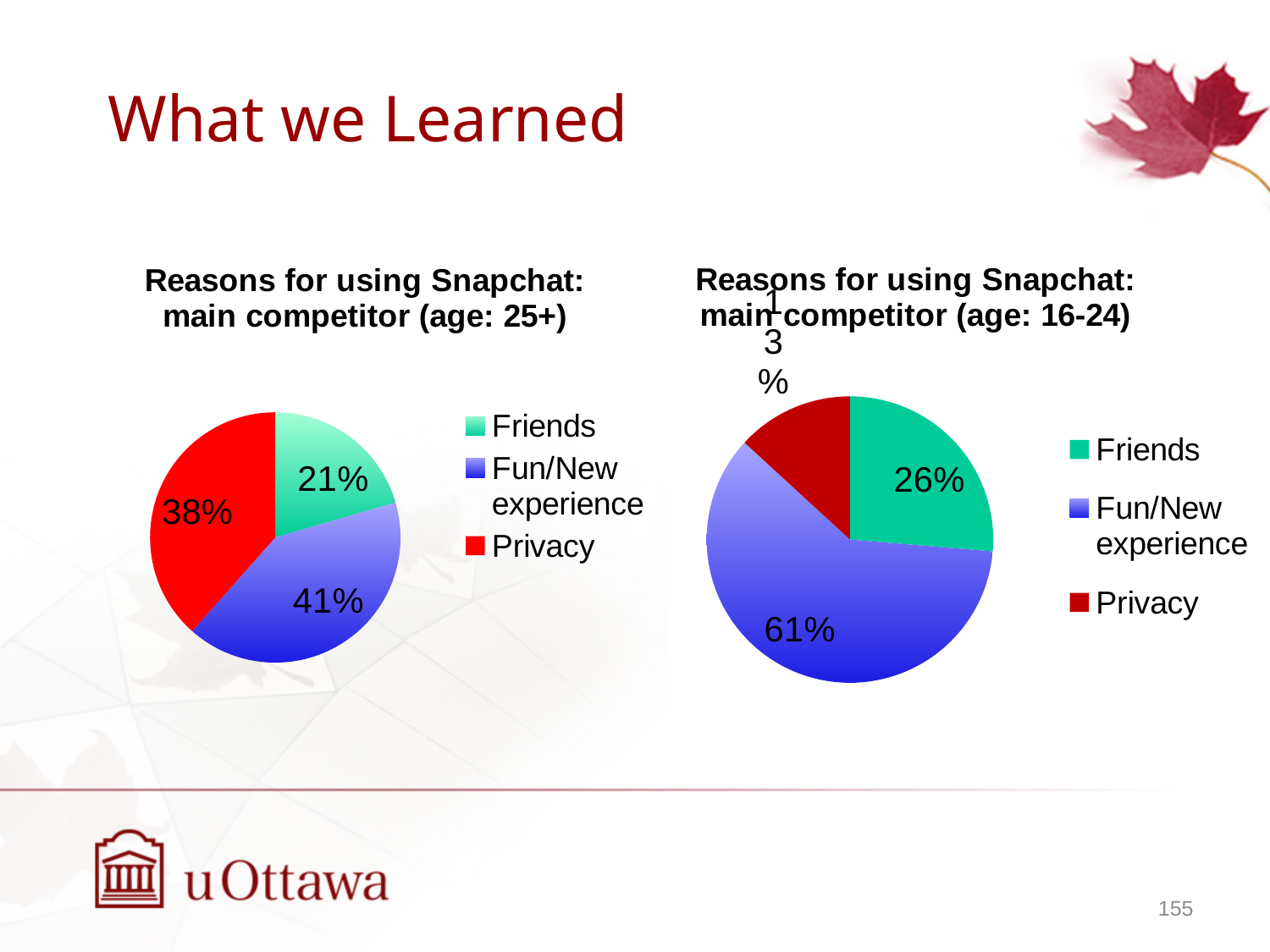
In the 'Reasons for using Snapchat: main competitor (age: 25+)' chart, what is the difference between the Fun/New experience and Friends percentages? 20% In the 'Reasons for using Snapchat: main competitor (age: 16-24)' chart, which reason has the smallest slice? Privacy In the 'Reasons for using Snapchat: main competitor (age: 16-24)' chart, what percentage is shown for Fun/New experience? 61% In the 'Reasons for using Snapchat: main competitor (age: 25+)' chart, what percentage is shown for Fun/New experience? 41% In the 'Reasons for using Snapchat: main competitor (age: 16-24)' chart, which reason has the largest slice? Fun/New experience How many categories does the legend of the 'Reasons for using Snapchat: main competitor (age: 25+)' chart list? 3 In the 'Reasons for using Snapchat: main competitor (age: 16-24)' chart, what percentage is shown for Friends? 26% What type of chart is used for 'Reasons for using Snapchat: main competitor (age: 16-24)'? Pie chart In the 'Reasons for using Snapchat: main competitor (age: 25+)' chart, which reason has the smallest slice? Friends Which is larger in the 'Reasons for using Snapchat: main competitor (age: 25+)' chart: Privacy or Friends? Privacy In the 'Reasons for using Snapchat: main competitor (age: 25+)' chart, what percentage is shown for Friends? 21% In the 'Reasons for using Snapchat: main competitor (age: 25+)' chart, what percentage is shown for Privacy? 38%